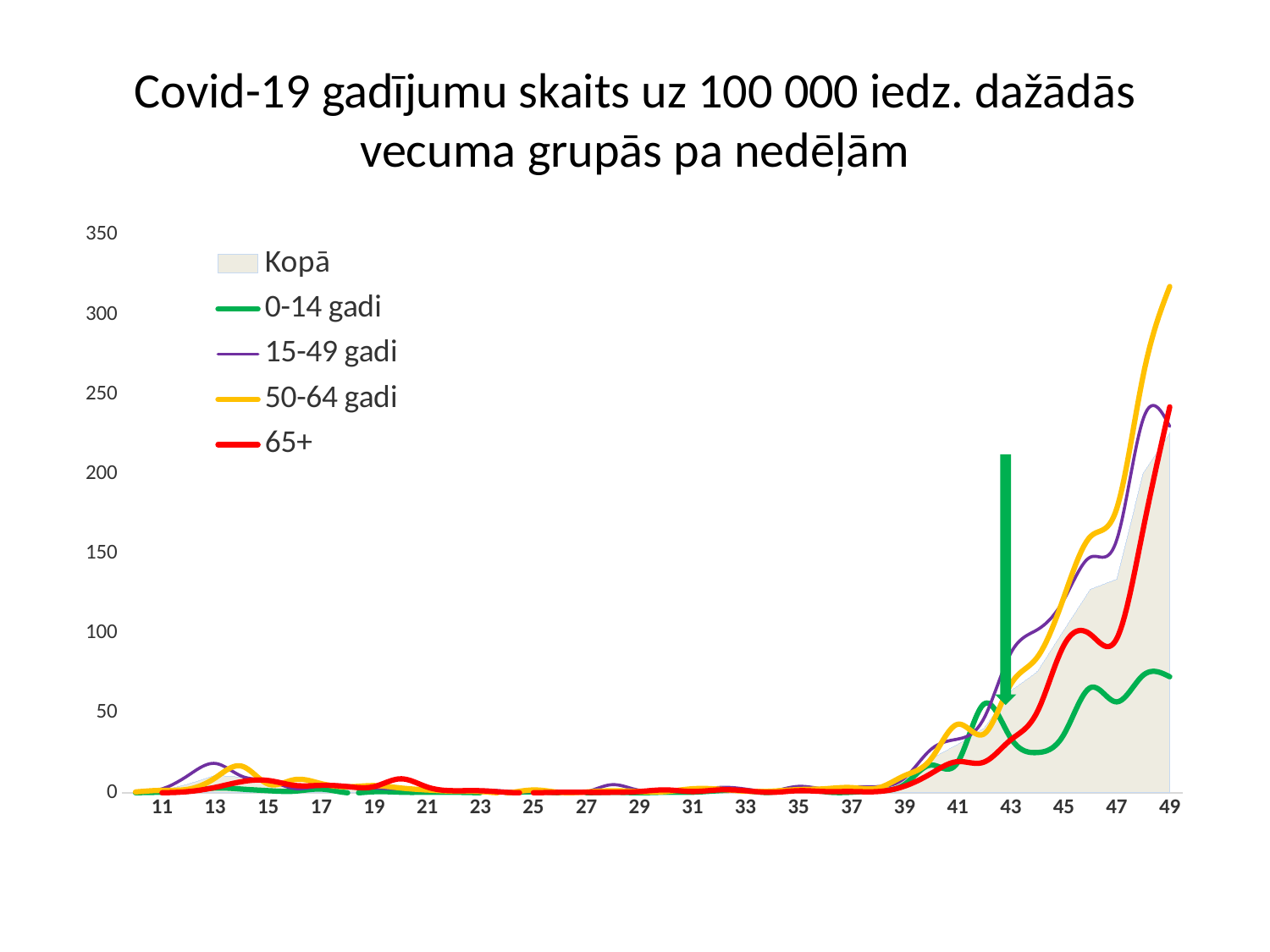
How many series does the legend list? 5 Which series has the highest value at week 49? 50-64 gadi Is the value for 50-64 gadi at week 49 greater or less than 300? greater What colour is the line for the 65+ series? red Which age-group series has the lowest value at week 49? 0-14 gadi Is the value for 65+ at week 49 greater or less than 200? greater What kind of chart is shown on the slide? combination area and line chart Is the value for 15-49 gadi at week 43 greater or less than 50? greater How many week labels are shown on the x axis? 20 Do the values for 50-64 gadi rise or fall from week 39 to week 49? rise At week 49, which is larger: the value for 50-64 gadi or the value for 0-14 gadi? 50-64 gadi